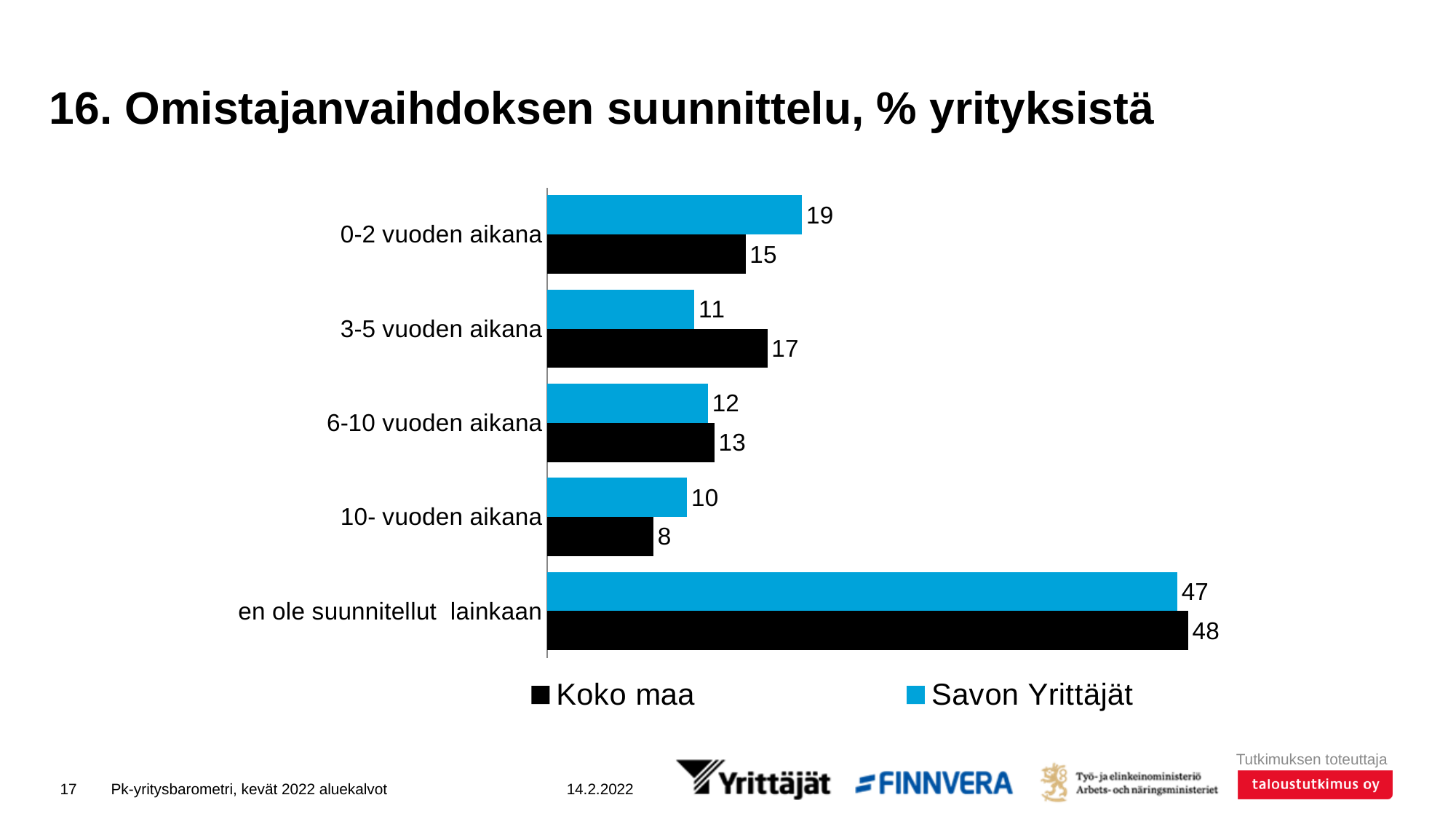
What is the value for Koko maa in the category '10- vuoden aikana'? 8 Which category has the lowest value for Koko maa? 10- vuoden aikana Which series has the larger value for '0-2 vuoden aikana', Koko maa or Savon Yrittäjät? Savon Yrittäjät What is the value for Savon Yrittäjät in the category '0-2 vuoden aikana'? 19 How many categories are shown on the chart? 5 How many series does the legend list? 2 Which category has the highest value for Savon Yrittäjät? en ole suunnitellut lainkaan What kind of chart is shown on the slide? bar chart What is the value for Savon Yrittäjät in the category 'en ole suunnitellut lainkaan'? 47 What is the value for Koko maa in the category '3-5 vuoden aikana'? 17 Which colour represents the Koko maa series in the chart? black What is the difference between the Savon Yrittäjät and Koko maa values for '3-5 vuoden aikana'? 6